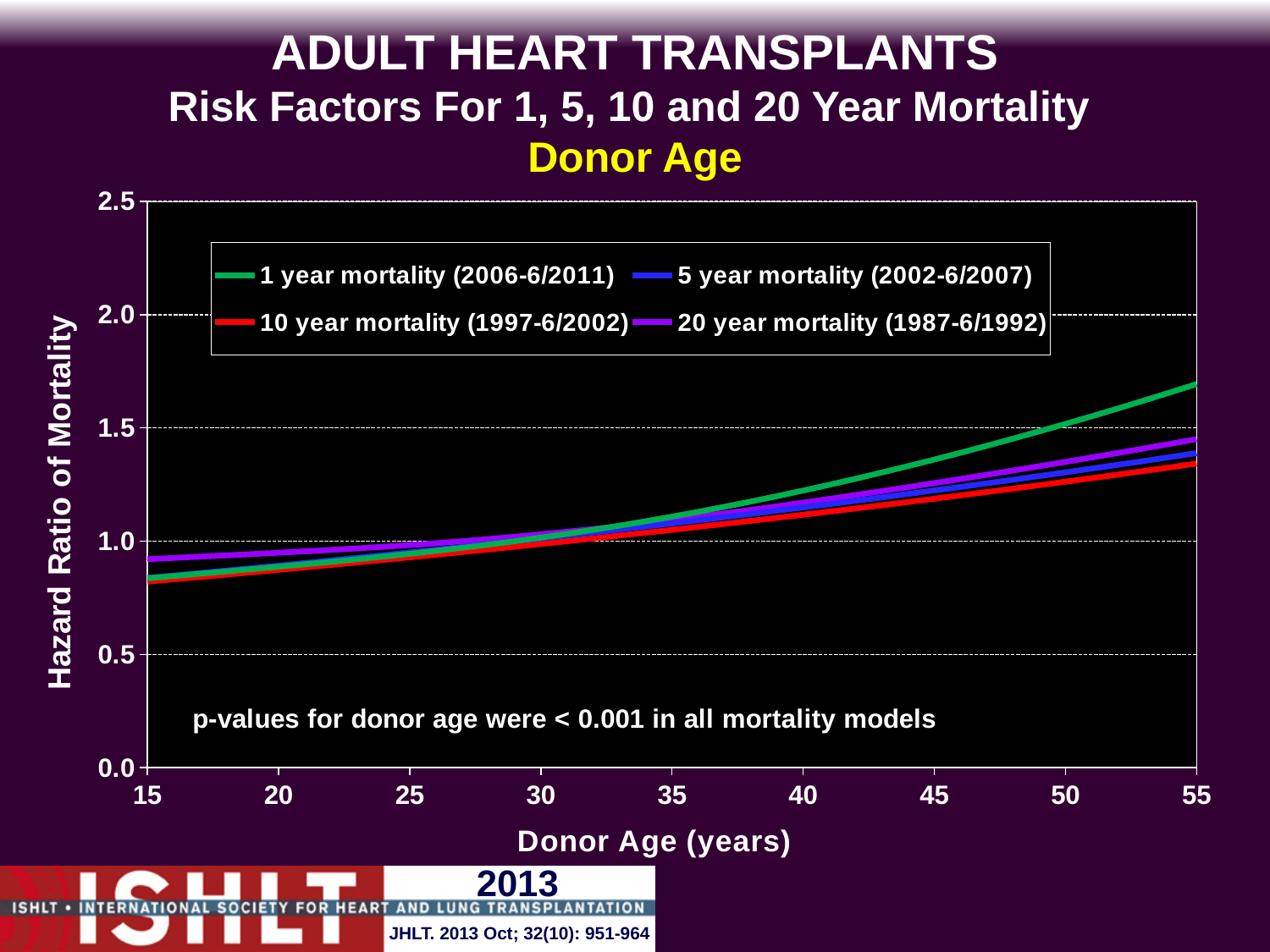
Does the hazard ratio for 1 year mortality rise or fall as donor age increases? rise What kind of chart is shown on the slide? line chart How many series does the legend list? 4 Is the hazard ratio for 1 year mortality at donor age 15 greater or less than 1.0? less Does the hazard ratio for 10 year mortality rise or fall as donor age increases from 15 to 55? rise At donor age 55, which is larger: the hazard ratio for 1 year mortality or for 10 year mortality? 1 year mortality Is the hazard ratio for 10 year mortality at donor age 55 greater or less than 1.5? less Is the hazard ratio for 20 year mortality at donor age 45 greater or less than 1.0? greater What is the label of the y axis? Hazard Ratio of Mortality Which colour represents 5 year mortality (2002-6/2007) in the legend? blue Which series has the highest hazard ratio at donor age 55? 1 year mortality (2006-6/2011)